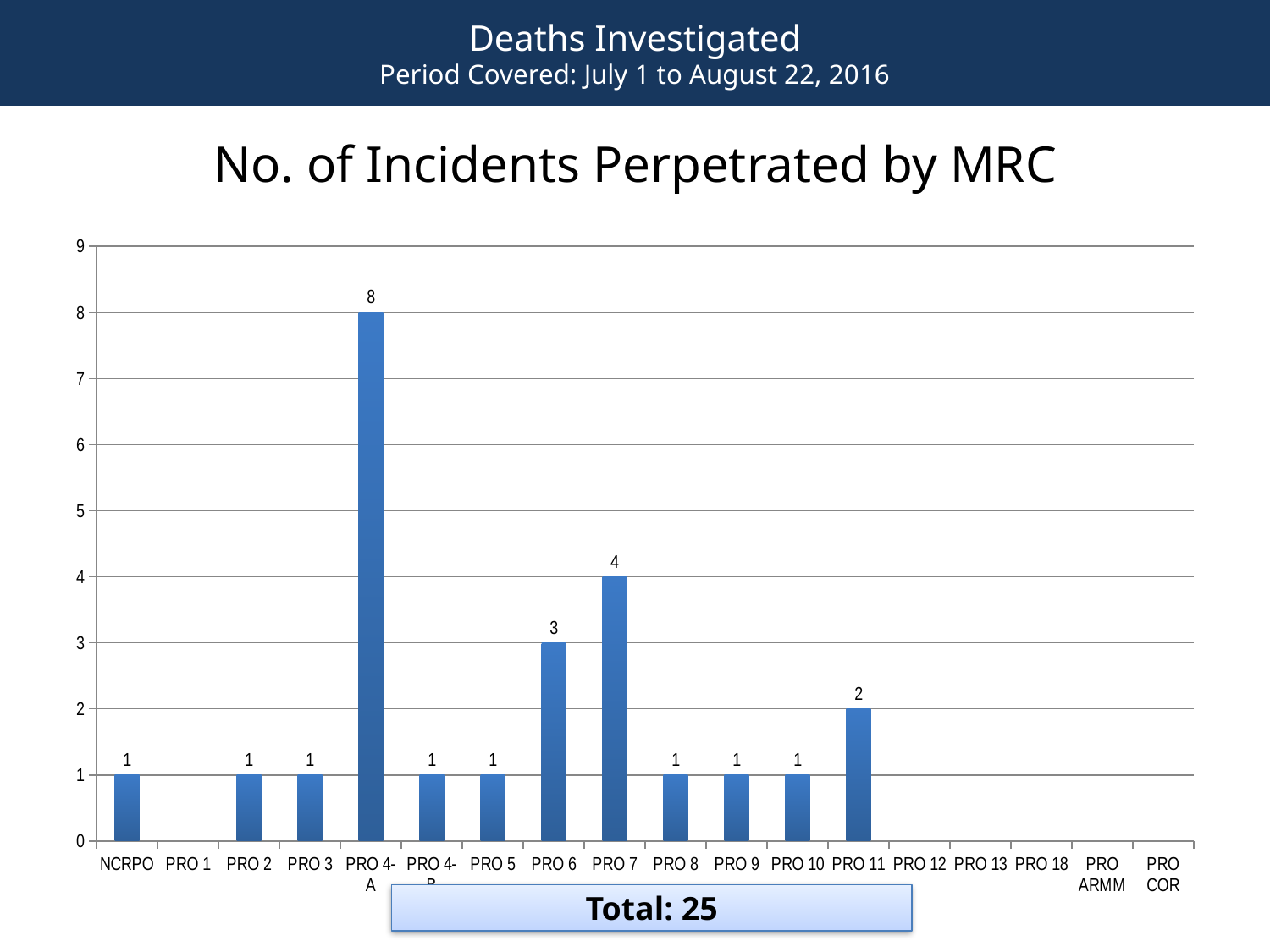
How many categories are shown on the x axis? 18 Which category has the highest number of incidents? PRO 4-A Which is larger, the value for PRO 7 or the value for PRO 6? PRO 7 What kind of chart is shown on the slide? Bar chart What is the value for PRO 4-A? 8 What is the value for PRO 6? 3 What is the value for PRO 7? 4 What is the difference between the values for PRO 6 and PRO 11? 1 What is the title of the chart? No. of Incidents Perpetrated by MRC What is the difference between the values for PRO 4-A and PRO 7? 4 Is the value for PRO 4-A greater or less than 5? greater What is the value for PRO 11? 2